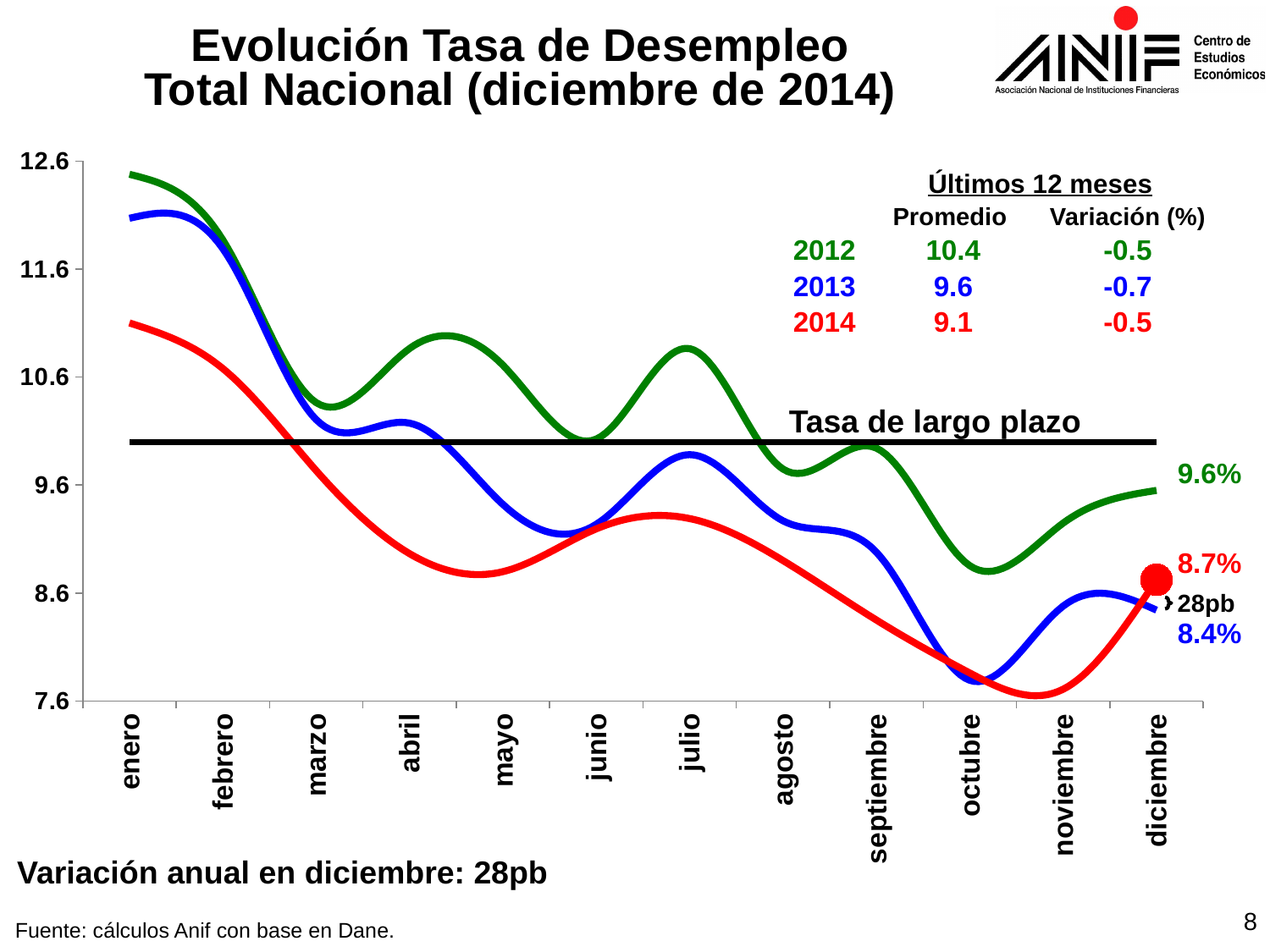
According to the table, what is the 'Promedio' for 2013 in the last 12 months? 9.6 What is the unemployment rate for December 2014 shown on the chart? 8.7% How many months are shown along the x axis? 12 Which year has the highest December value on the chart? 2012 What kind of chart is shown on the slide? line chart Is the January value of the 2014 (red) line greater or less than 11.6? less What is the unemployment rate for December 2013 shown on the chart? 8.4% How many years (series) are plotted on the chart? 3 Does the 2014 (red) line rise or fall from January to October? fall What is the unemployment rate for December 2012 shown on the chart? 9.6% What is the difference between the December 2012 value (9.6%) and the December 2014 value (8.7%)? 0.9 percentage points Which year has the lowest December value on the chart? 2013